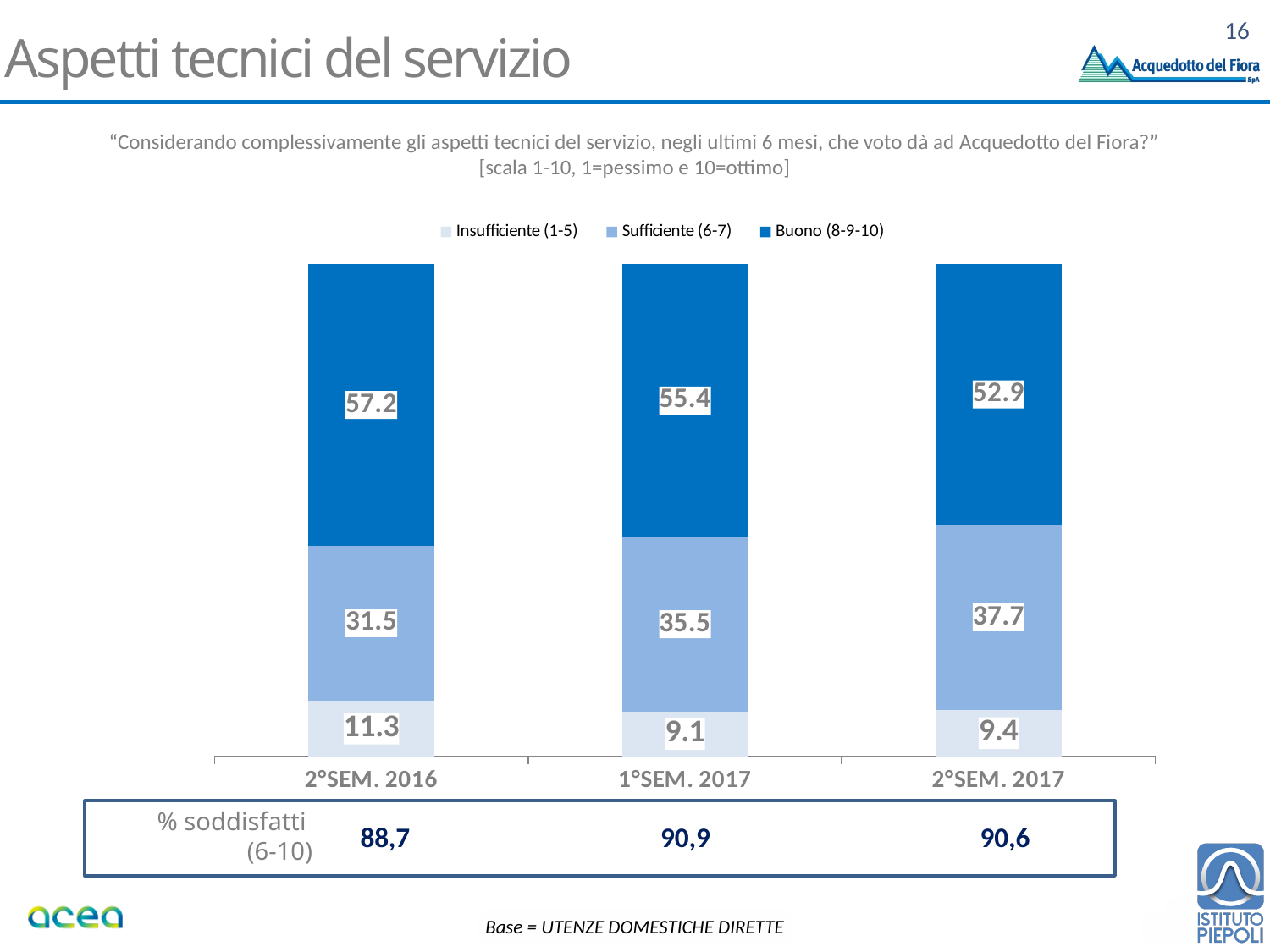
What kind of chart is shown on the slide? Stacked bar chart What is the value of Insufficiente (1-5) for 2°SEM. 2017? 9.4 What is the value of Buono (8-9-10) for 2°SEM. 2016? 57.2 Which category has the highest value for Buono (8-9-10)? 2°SEM. 2016 How many categories are shown on the x axis? 3 What is the difference between the Sufficiente (6-7) values for 2°SEM. 2017 and 2°SEM. 2016? 6.2 How many series does the legend list? 3 Which is larger: Buono (8-9-10) for 1°SEM. 2017 or for 2°SEM. 2017? 1°SEM. 2017 Does the Buono (8-9-10) value rise or fall from 2°SEM. 2016 to 2°SEM. 2017? Fall Which category has the lowest value for Insufficiente (1-5)? 1°SEM. 2017 What is the total of the stacked bar for 1°SEM. 2017? 100 What is the value of Sufficiente (6-7) for 1°SEM. 2017? 35.5